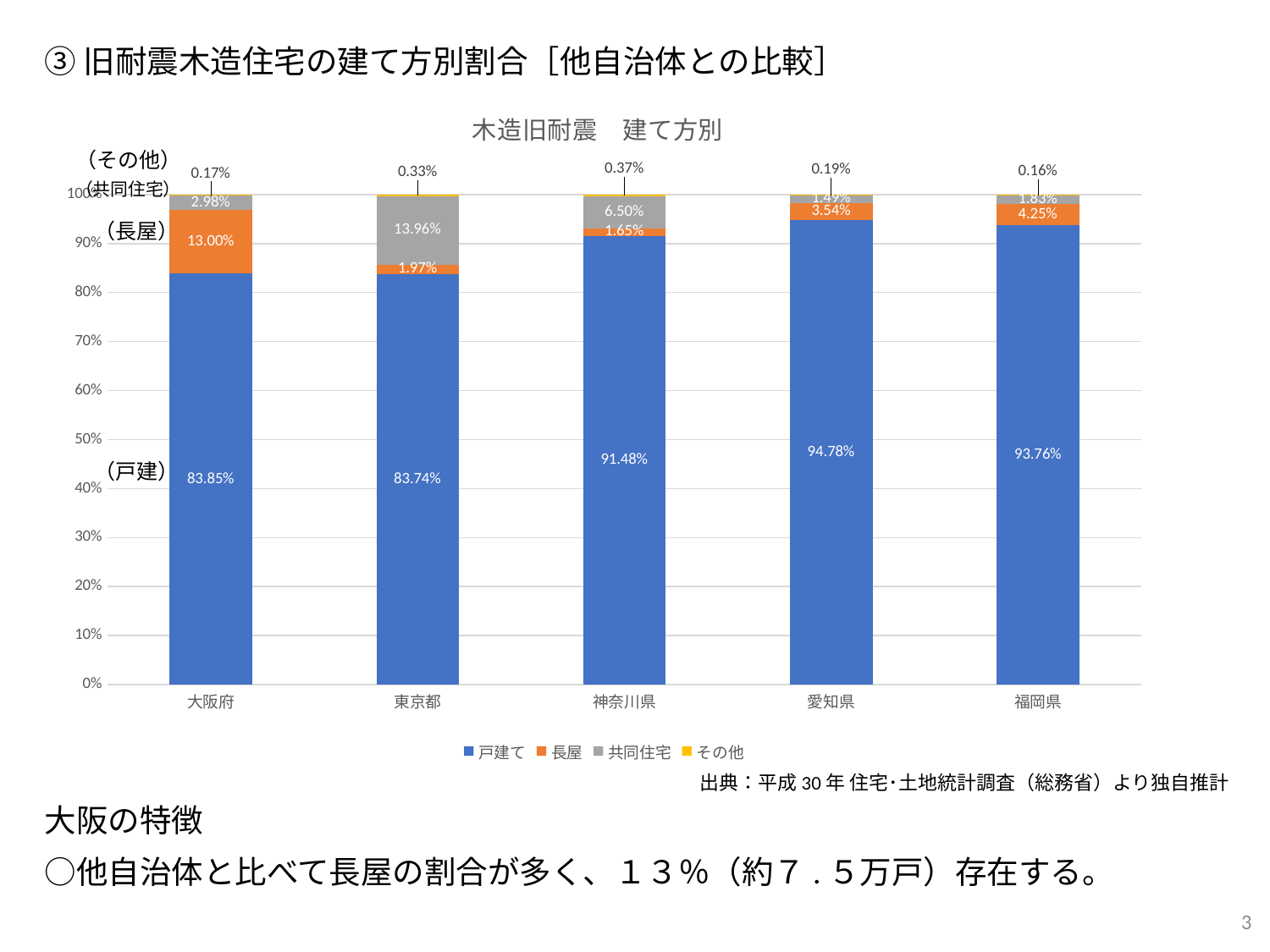
How many series does the legend list? 4 What type of chart is shown on the slide? stacked bar chart What is the 共同住宅 value for 東京都? 13.96% What is the 長屋 value for 大阪府? 13.00% What is the difference between the 長屋 value for 大阪府 and the 長屋 value for 福岡県? 8.75% What is the 戸建て value for 大阪府? 83.85% How many prefectures are shown on the x axis? 5 What is the その他 value for 神奈川県? 0.37% Which prefecture has the highest 戸建て share? 愛知県 What is the 戸建て value for 愛知県? 94.78% Which is larger, the 共同住宅 value for 神奈川県 or the 共同住宅 value for 大阪府? 神奈川県 Which prefecture has the lowest 戸建て share? 東京都